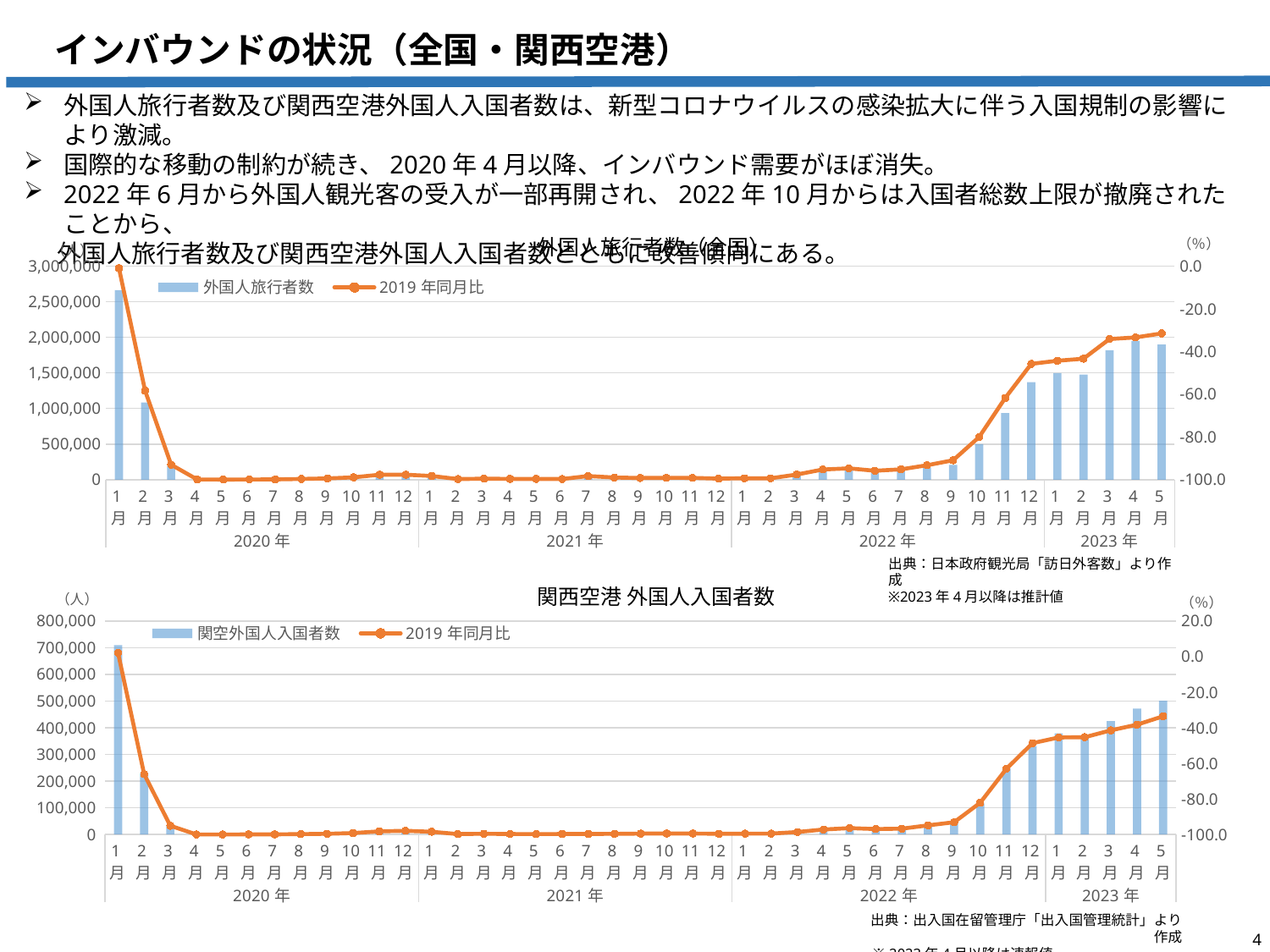
In the bottom chart (関西空港 外国人入国者数), which is larger, the 関空外国人入国者数 bar for 2023年1月 or for 2023年5月? 2023年5月 In the bottom chart (関西空港 外国人入国者数), is the 関空外国人入国者数 value for 2023年4月 greater or less than 400,000? greater In the top chart (外国人旅行者数（全国）), is the 外国人旅行者数 value for 2023年5月 greater or less than 2,000,000? less In the bottom chart (関西空港 外国人入国者数), which month has the highest 関空外国人入国者数 bar? 2020年1月 In the top chart (外国人旅行者数（全国）), is the 外国人旅行者数 value for 2020年1月 greater or less than 2,500,000? greater In the top chart (外国人旅行者数（全国）), which is larger, the 外国人旅行者数 bar for 2023年2月 or for 2023年3月? 2023年3月 What are the two legend entries of the bottom chart (関西空港 外国人入国者数)? 関空外国人入国者数 and 2019年同月比 What kind of chart is the top chart titled 外国人旅行者数（全国）? A combined bar and line chart In the top chart (外国人旅行者数（全国）), do the 外国人旅行者数 bars rise or fall from 2022年6月 to 2023年5月? rise In the top chart (外国人旅行者数（全国）), which month has the highest 外国人旅行者数 bar? 2020年1月 How many series does the legend of the top chart (外国人旅行者数（全国）) list? 2